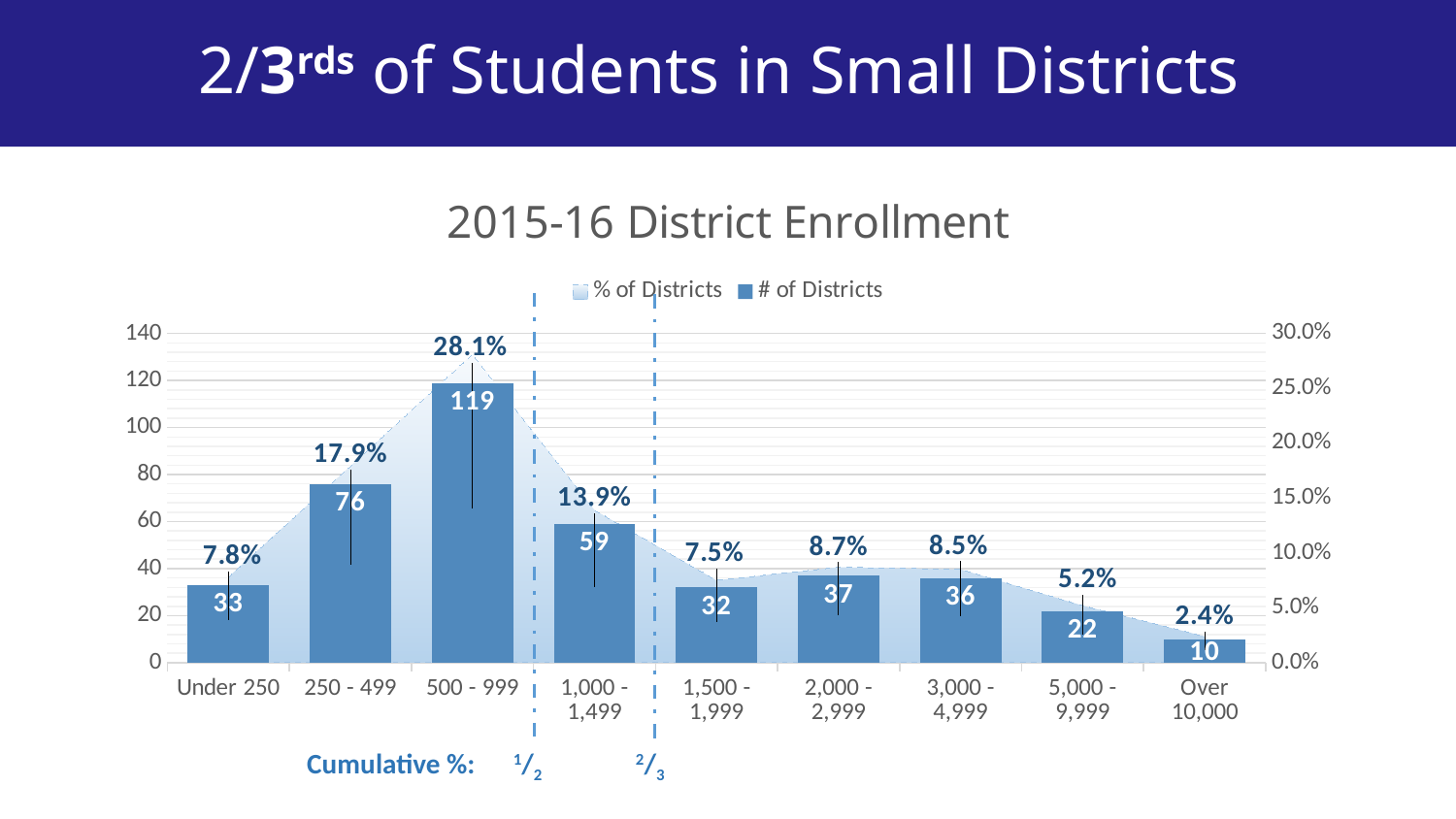
What is the title of the chart? 2015-16 District Enrollment What is the # of Districts for the 500 - 999 category? 119 Which category has the lowest % of Districts? Over 10,000 What is the % of Districts for the 250 - 499 category? 17.9% Is the # of Districts for the 250 - 499 category greater or less than 60? greater Which category has the highest # of Districts? 500 - 999 What is the difference in # of Districts between the 500 - 999 and 1,000 - 1,499 categories? 60 What is the # of Districts for the Over 10,000 category? 10 Which has more districts, the 2,000 - 2,999 category or the 3,000 - 4,999 category? 2,000 - 2,999 How many series does the legend list? 2 How many enrollment categories are shown on the x axis? 9 What is the % of Districts for the 1,500 - 1,999 category? 7.5%